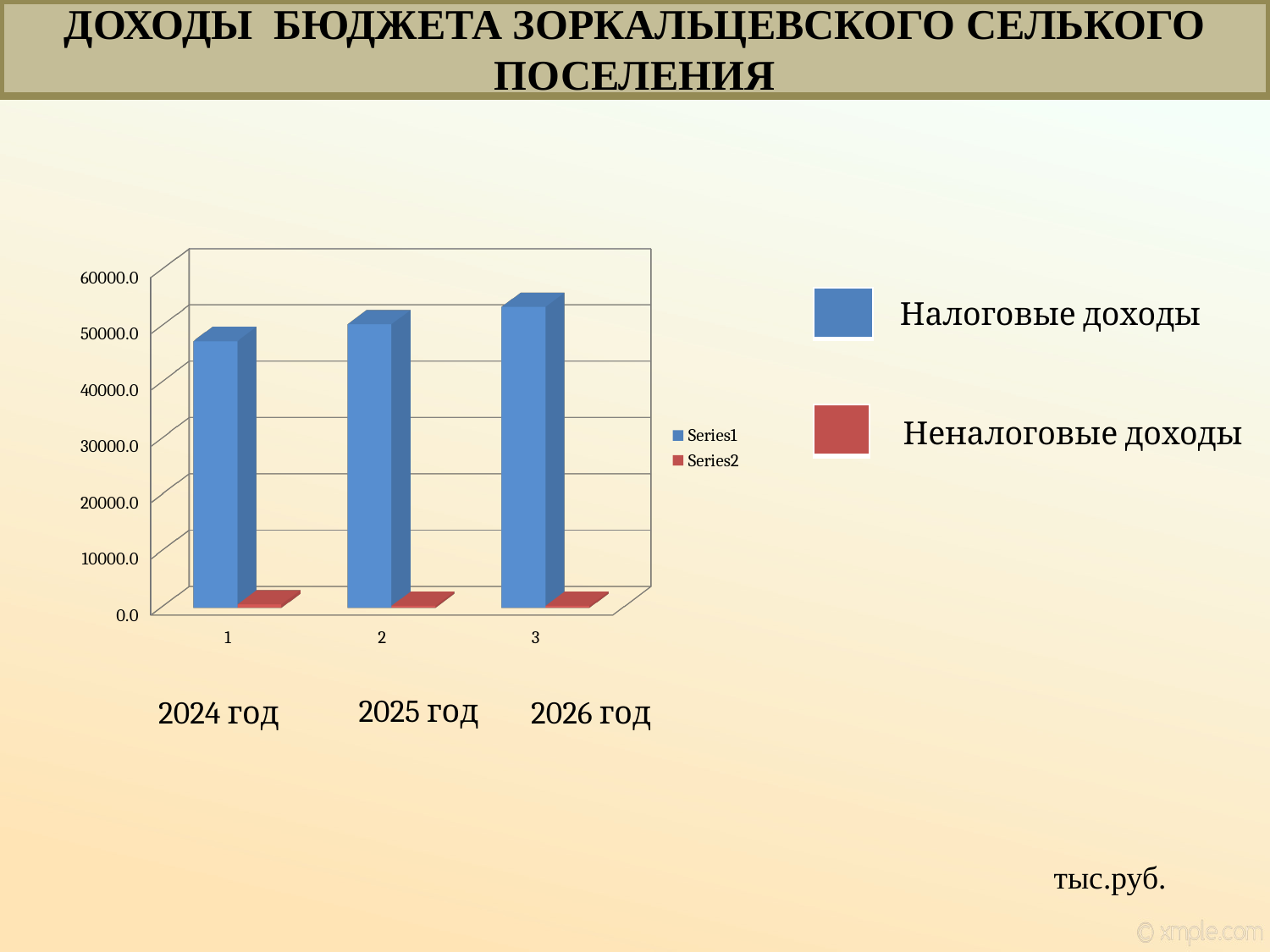
What unit is indicated for the chart values on the slide? тыс.руб. What colour are the bars for Налоговые доходы? blue Do the Series1 values rise or fall from category 1 to category 3? rise Which category has the highest value for Series1? 3 In category 2, which is larger: Series1 or Series2? Series1 What kind of chart is shown on the slide? bar chart Is the value for Series2 in category 2 greater or less than 10000.0? less Which category has the lowest value for Series1? 1 How many series does the chart legend list? 2 Is the value for Series1 in category 3 greater or less than 50000.0? greater How many categories are shown on the x axis of the chart? 3 Is the value for Series1 in category 1 greater or less than 40000.0? greater